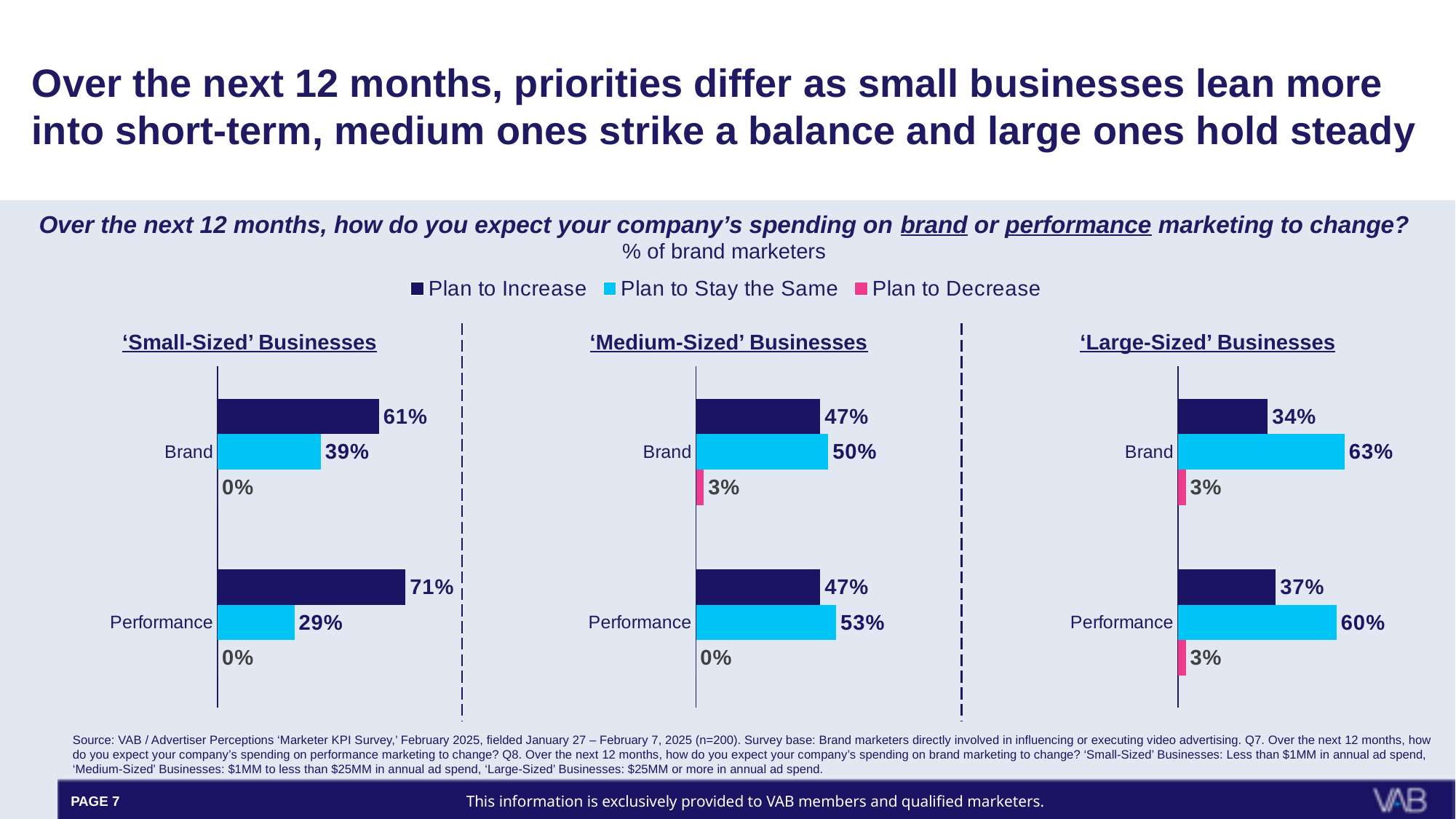
In the 'Large-Sized' Businesses chart, what percentage plan to increase spending on Brand marketing? 34% In the 'Large-Sized' Businesses chart, what is the difference between Plan to Stay the Same for Brand and Plan to Stay the Same for Performance? 3% What kind of chart is used on this slide? Bar chart In the 'Medium-Sized' Businesses chart, which is larger for Performance: Plan to Increase or Plan to Stay the Same? Plan to Stay the Same In the 'Medium-Sized' Businesses chart, what percentage plan to stay the same on Brand marketing spending? 50% Across the three charts, which business size has the highest Plan to Increase value for Performance marketing? 'Small-Sized' Businesses How many series does the legend list? 3 How many categories are shown in the 'Medium-Sized' Businesses chart? 2 In the 'Large-Sized' Businesses chart, what percentage plan to decrease spending on Performance marketing? 3% In the 'Small-Sized' Businesses chart, what is the difference between the Plan to Increase values for Performance and Brand? 10% In the 'Small-Sized' Businesses chart, what percentage plan to increase spending on Performance marketing? 71% Which colour represents Plan to Decrease in the legend? Pink